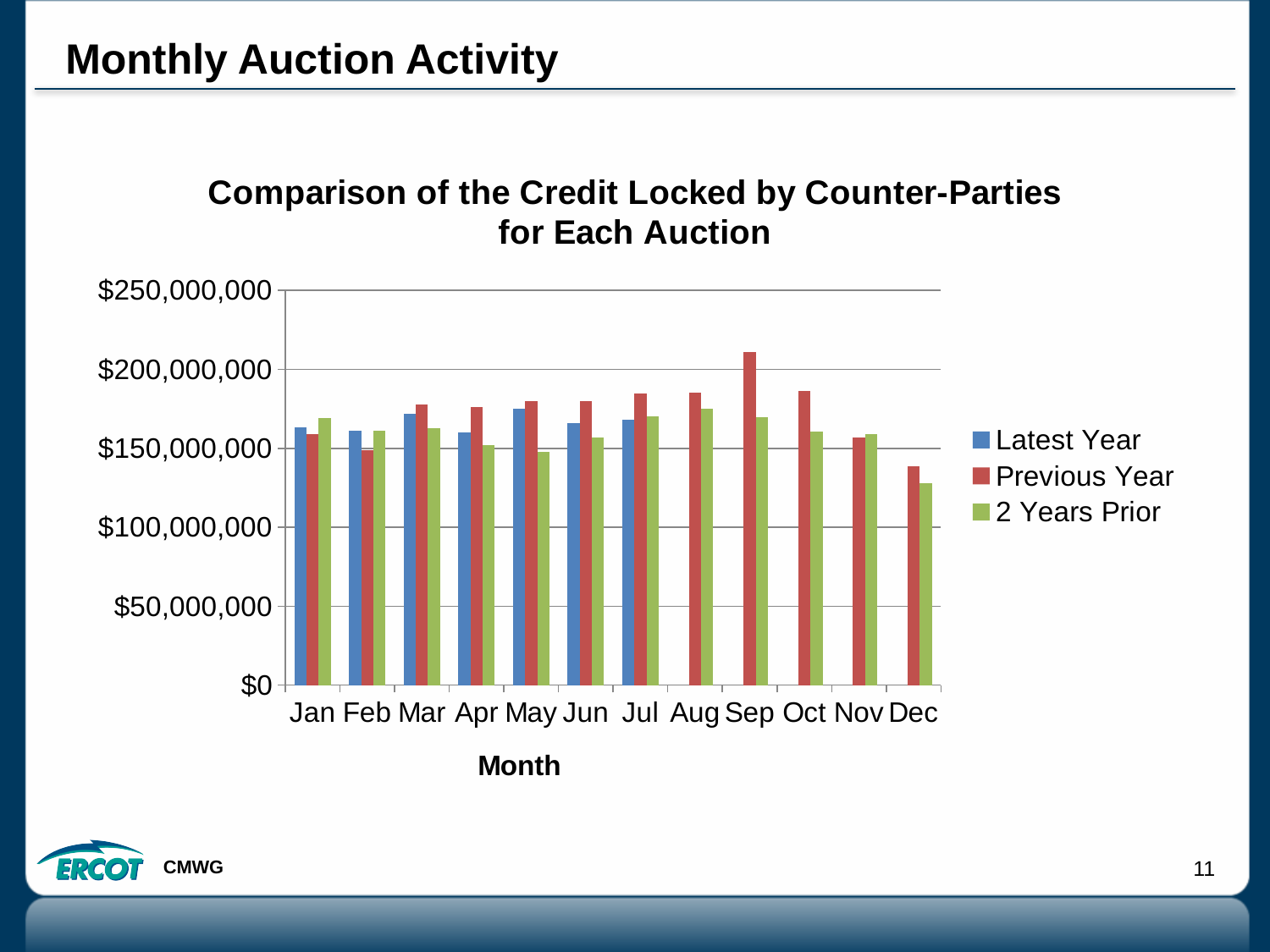
In Sep, which is larger: the Previous Year value or the 2 Years Prior value? Previous Year Which month has the lowest Previous Year value? Dec What is the title of the chart? Comparison of the Credit Locked by Counter-Parties for Each Auction Is the Previous Year value for Apr greater or less than $150,000,000? greater Is the Previous Year value for Sep greater or less than $200,000,000? greater In Feb, which is larger: the Latest Year value or the Previous Year value? Latest Year Which month has the highest Previous Year value? Sep How many months are shown on the x axis? 12 What kind of chart is shown on the slide? Bar chart Which month has the lowest 2 Years Prior value? Dec Is the 2 Years Prior value for Dec greater or less than $150,000,000? less How many series does the legend list? 3